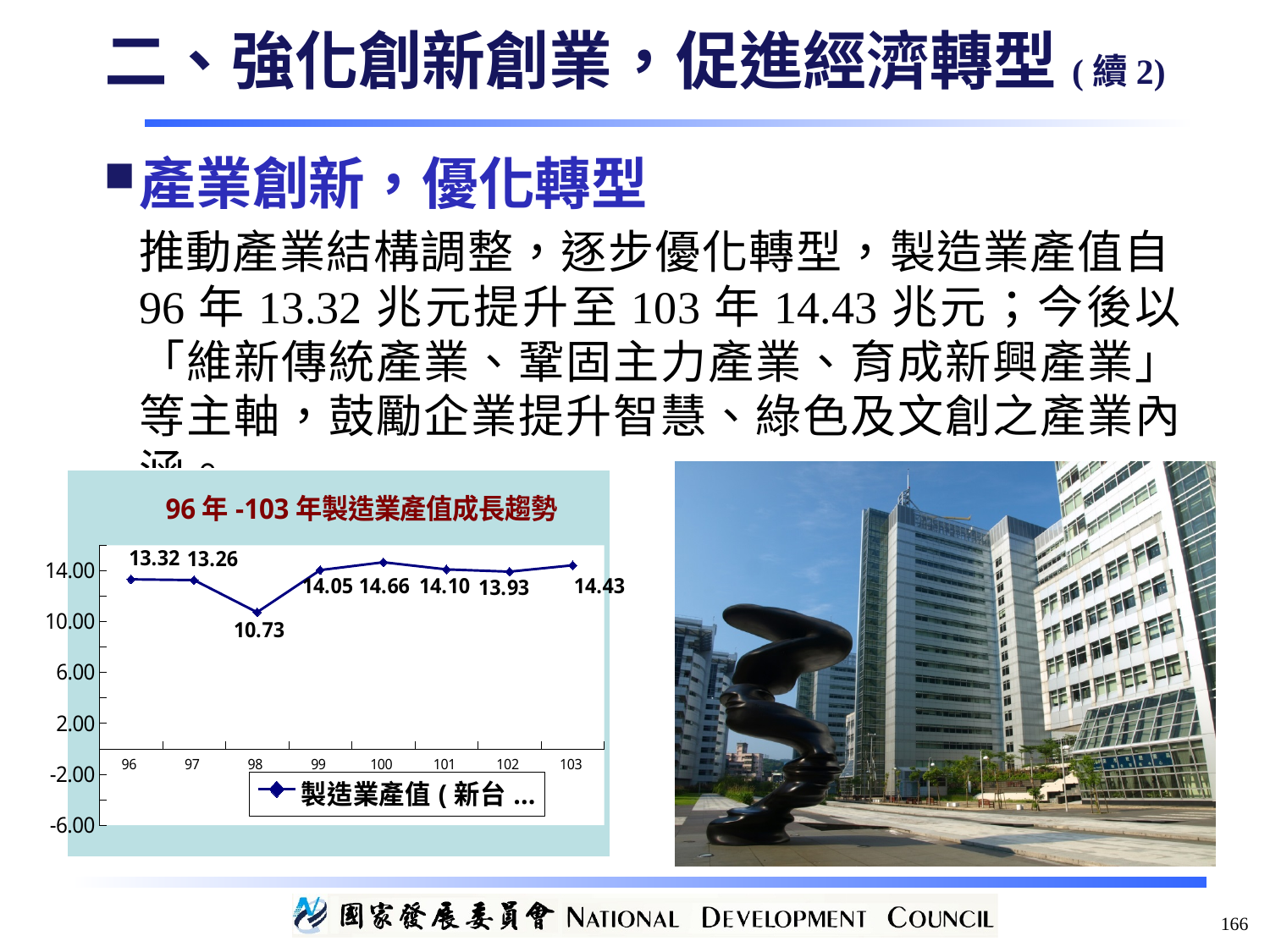
How many years are plotted on the x axis of the chart? 8 Which year has a larger manufacturing output value, 99 or 101? 101 What is the manufacturing output value for year 103 in the chart? 14.43 Which year has the lowest manufacturing output value in the chart? 98 Is the value for year 98 greater or less than 14.00? less What is the difference between the manufacturing output value in year 103 and year 96? 1.11 What is the manufacturing output value for year 98 in the chart? 10.73 What is the manufacturing output value for year 96 in the chart? 13.32 What kind of chart is shown on the slide? line chart How many series does the chart's legend list? 1 What is the title of the chart on the slide? 96年-103年製造業產值成長趨勢 Which year has the highest manufacturing output value in the chart? 100